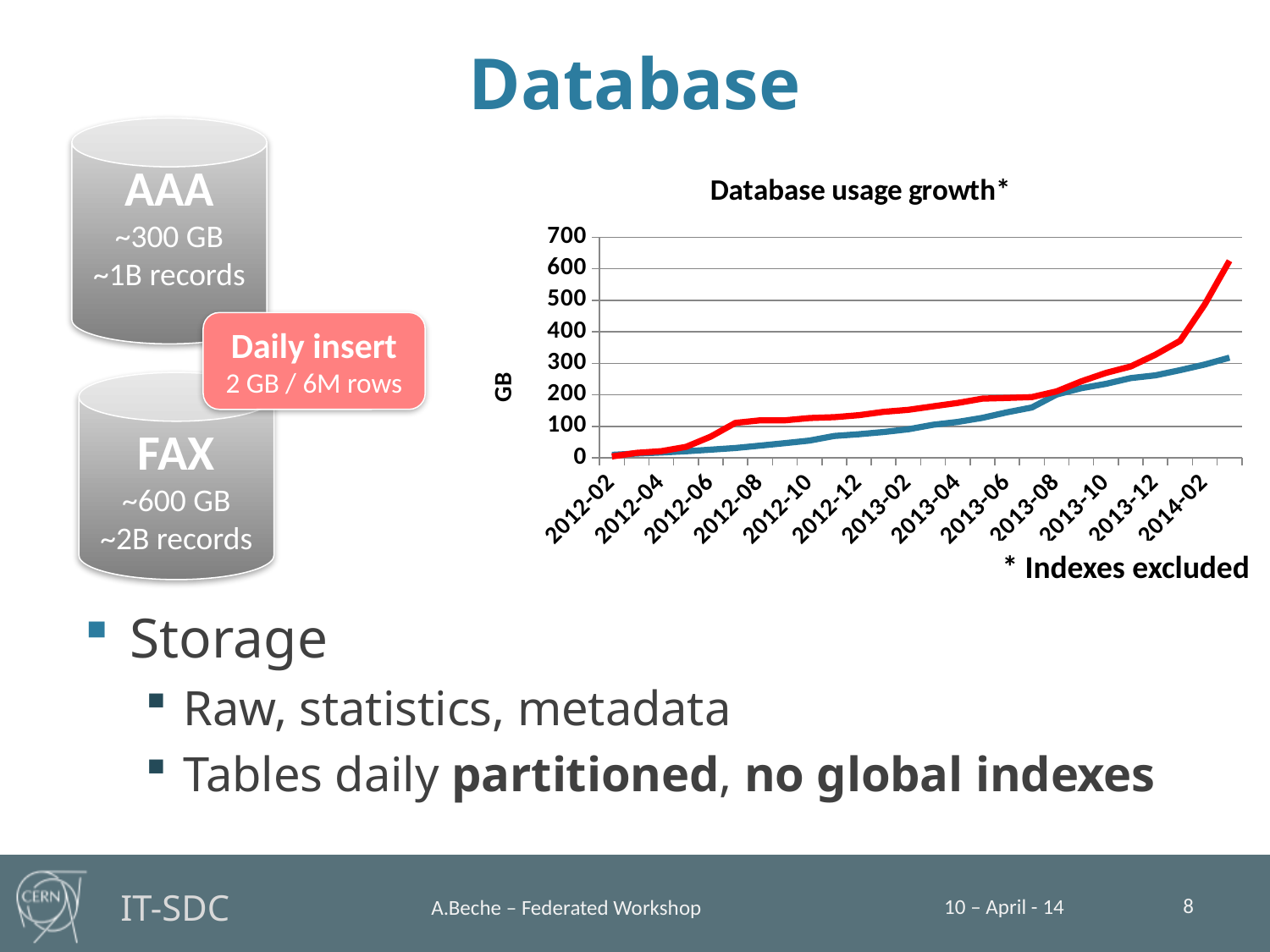
Which line reaches the higher value at 2014-02, the red line or the blue line? the red line Is the value of the red line at 2013-06 greater or less than 300? less Which line has the highest value anywhere on the chart, the red line or the blue line? the red line What kind of chart is shown on the slide? line chart How many date labels are shown along the x axis of the chart? 13 Is the value of the blue line at 2012-08 greater or less than 100? less Do the values on the chart rise or fall from 2012-02 to 2014-02? rise How many lines are plotted on the chart? 2 What is the label on the vertical axis of the chart? GB Is the value of the blue line at 2014-02 greater or less than 200? greater What is the title of the chart? Database usage growth*